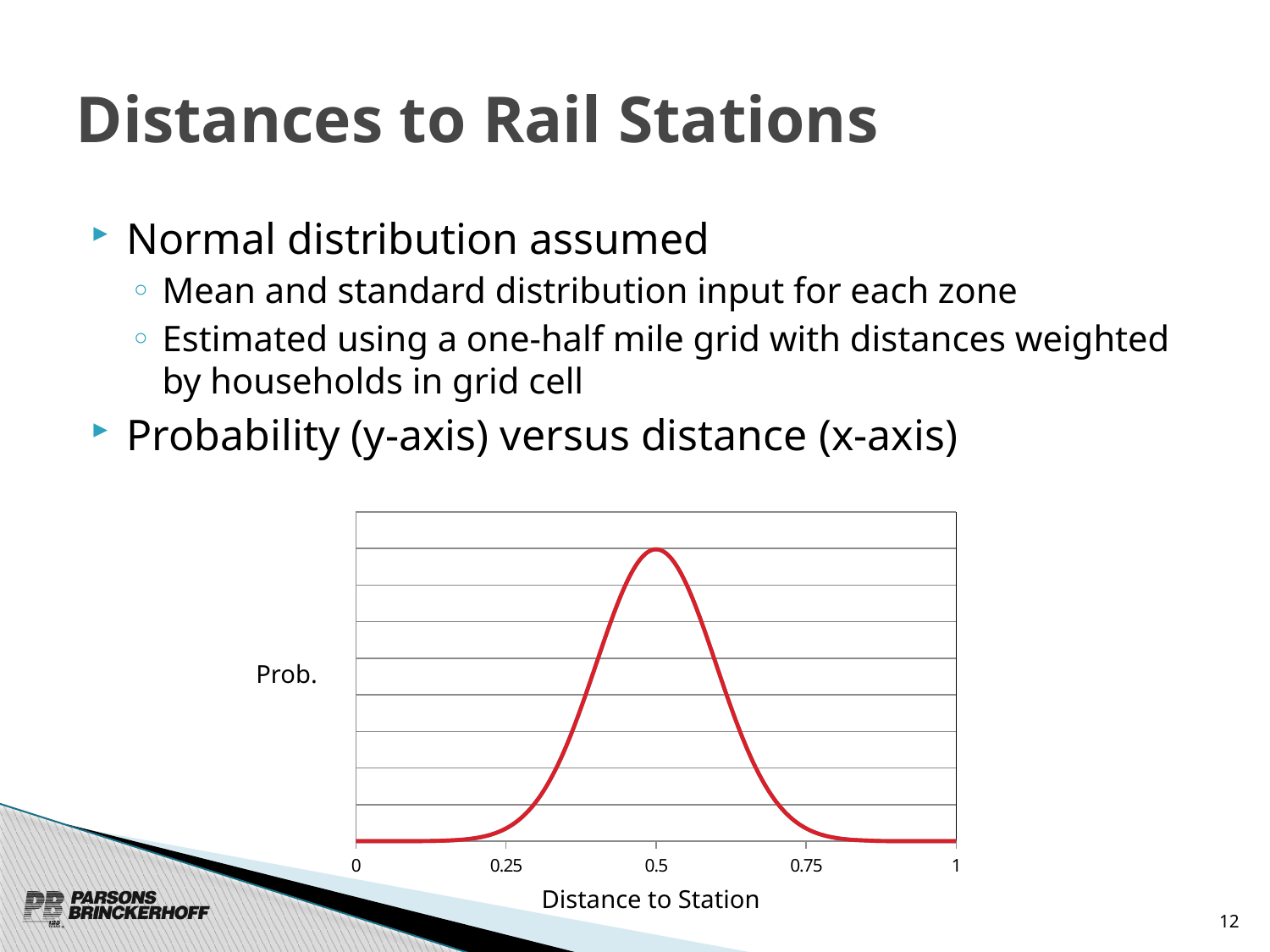
What is the largest value labelled on the x axis of the chart? 1 At which distance to station does the curve reach its highest value? 0.5 How does the probability change as distance to station increases from 0.5 to 1? It falls Is the probability at a distance of 0.75 larger or smaller than the probability at a distance of 0.5? Smaller What is the label of the y axis of the chart? Prob. What kind of chart is shown on the slide? Line chart How many tick labels are shown on the x axis of the chart? 5 Is the probability at a distance of 0.5 larger or smaller than the probability at a distance of 0.25? Larger How does the probability change as distance to station increases from 0 to 0.5? It rises What is the label of the x axis of the chart? Distance to Station